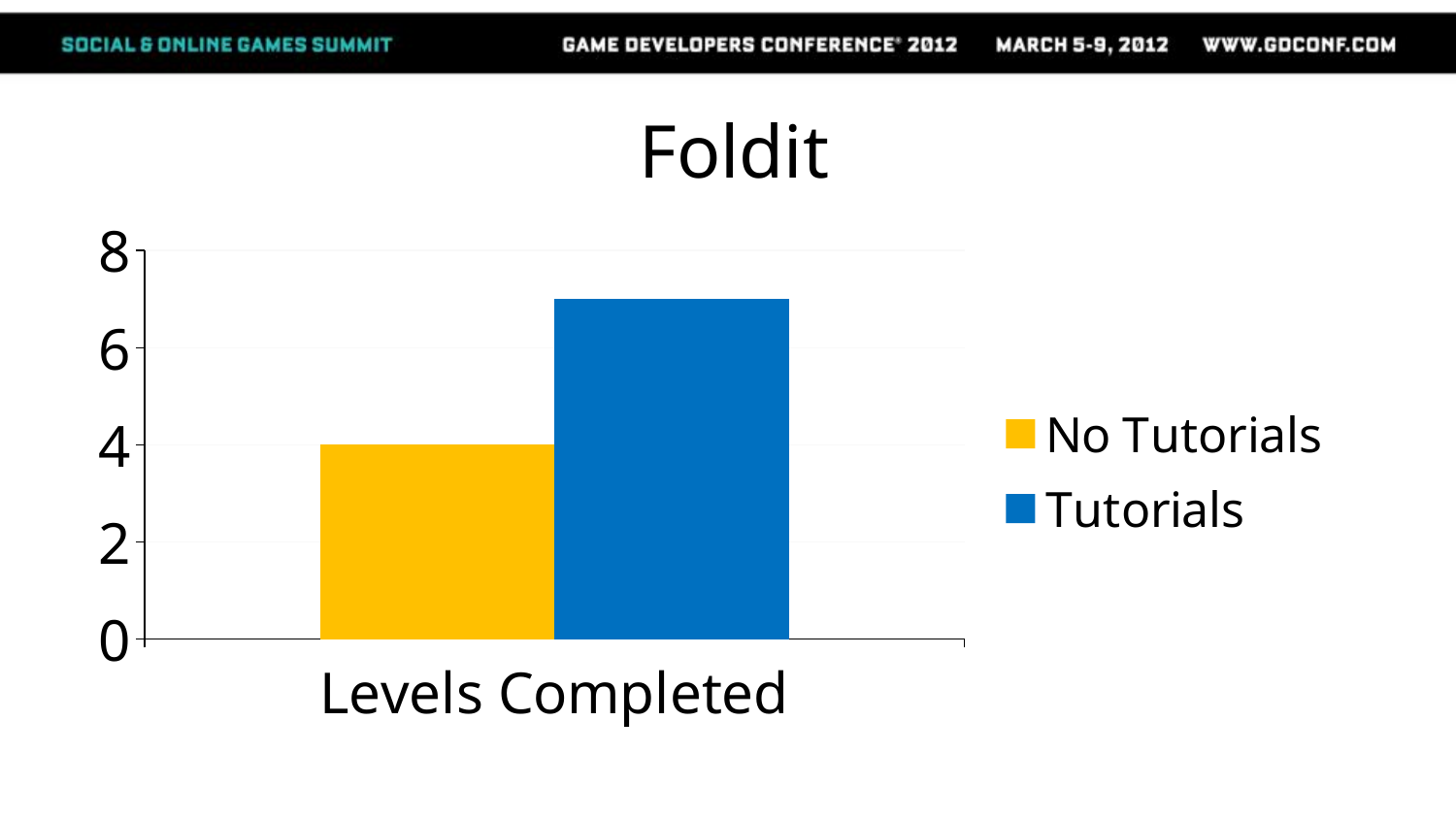
Which series has the higher value for Levels Completed? Tutorials Which is larger, the value for Tutorials or the value for No Tutorials? Tutorials What is the value for No Tutorials in the Levels Completed category? 4 Is the value for No Tutorials greater or less than 6? less What kind of chart is shown on the slide? bar chart How many categories are shown on the x axis? 1 What colour represents the Tutorials series? blue How many series does the legend list? 2 Which series has the lower value for Levels Completed? No Tutorials What is the title of the chart? Foldit Is the value for Tutorials greater or less than 6? greater